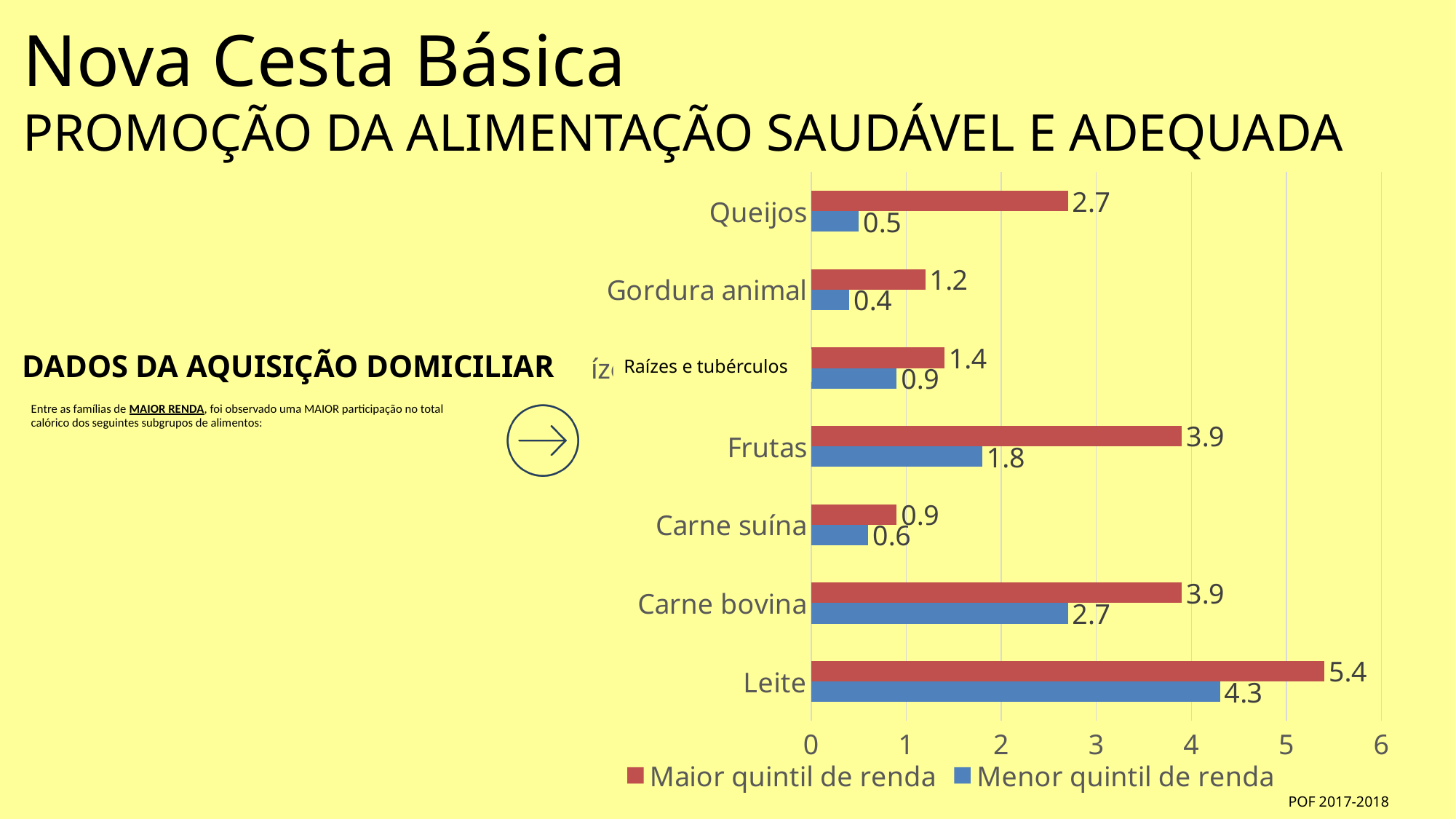
What is the value for Frutas in the Menor quintil de renda series? 1.8 Which category has the highest value in the Maior quintil de renda series? Leite What is the value for Leite in the Maior quintil de renda series? 5.4 How many series does the legend list? 2 How many food categories are shown on the chart? 7 Is the Maior quintil de renda value for Leite greater or less than 5? greater What is the value for Queijos in the Menor quintil de renda series? 0.5 What is the difference between the Maior quintil de renda and Menor quintil de renda values for Carne bovina? 1.2 What kind of chart is shown on the slide? Bar chart Which is larger for Queijos: the Maior quintil de renda value or the Menor quintil de renda value? Maior quintil de renda Which category has the lowest value in the Menor quintil de renda series? Gordura animal What colour represents the Menor quintil de renda series? Blue